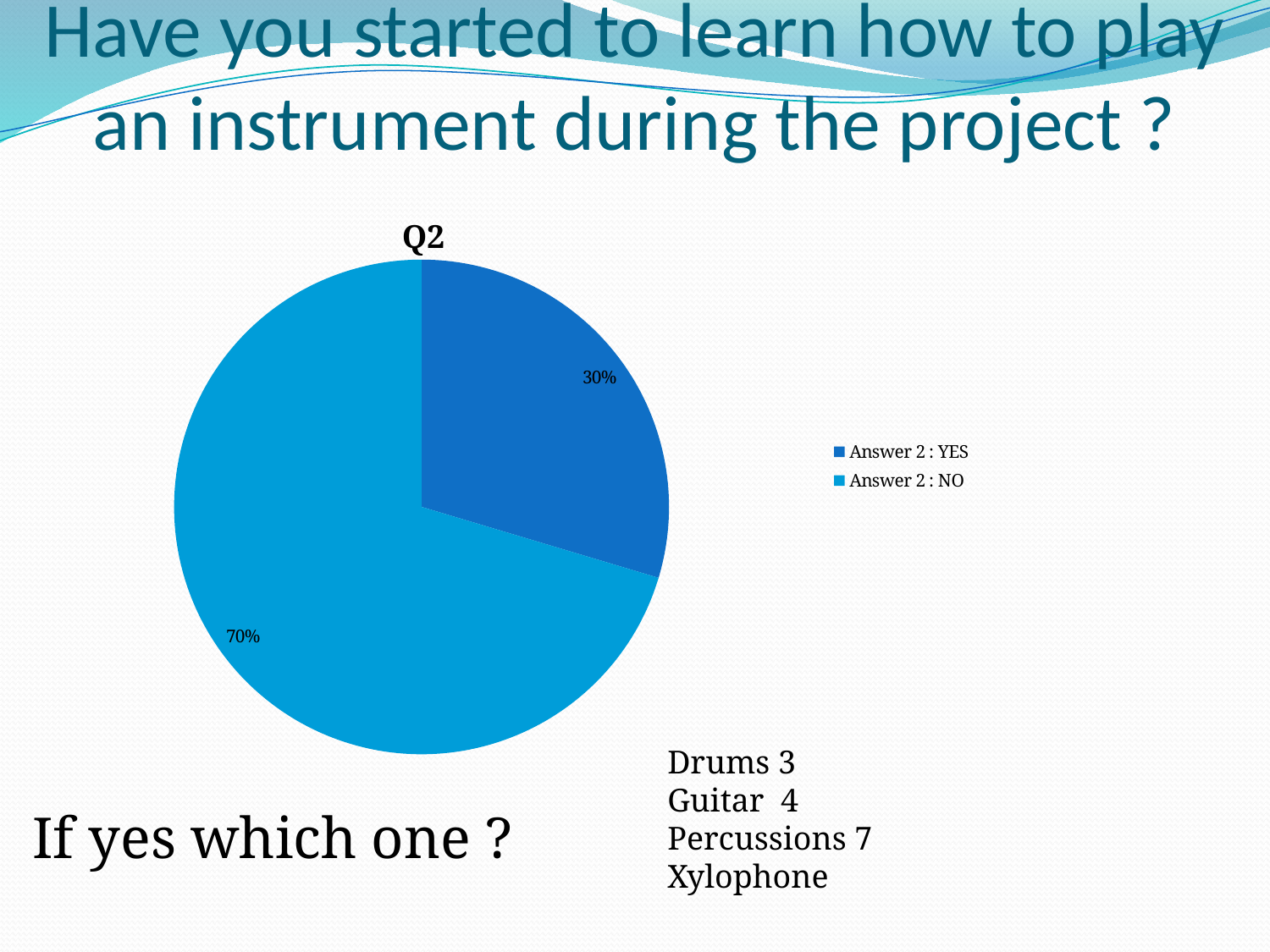
Which slice of the pie is the largest? Answer 2 : NO Which legend entry is shown in the lighter blue colour? Answer 2 : NO How many slices does the pie chart have? 2 What is the difference in percentage points between the NO slice and the YES slice? 40 What is the title of the chart? Q2 What percentage of the pie is labelled for "Answer 2 : YES"? 30% How many entries does the legend list? 2 Which slice of the pie is the smallest? Answer 2 : YES What percentage of the pie is labelled for "Answer 2 : NO"? 70% What kind of chart is shown on the slide? pie chart Which is larger, the YES slice or the NO slice? Answer 2 : NO What share of the pie does the YES slice represent? 30%